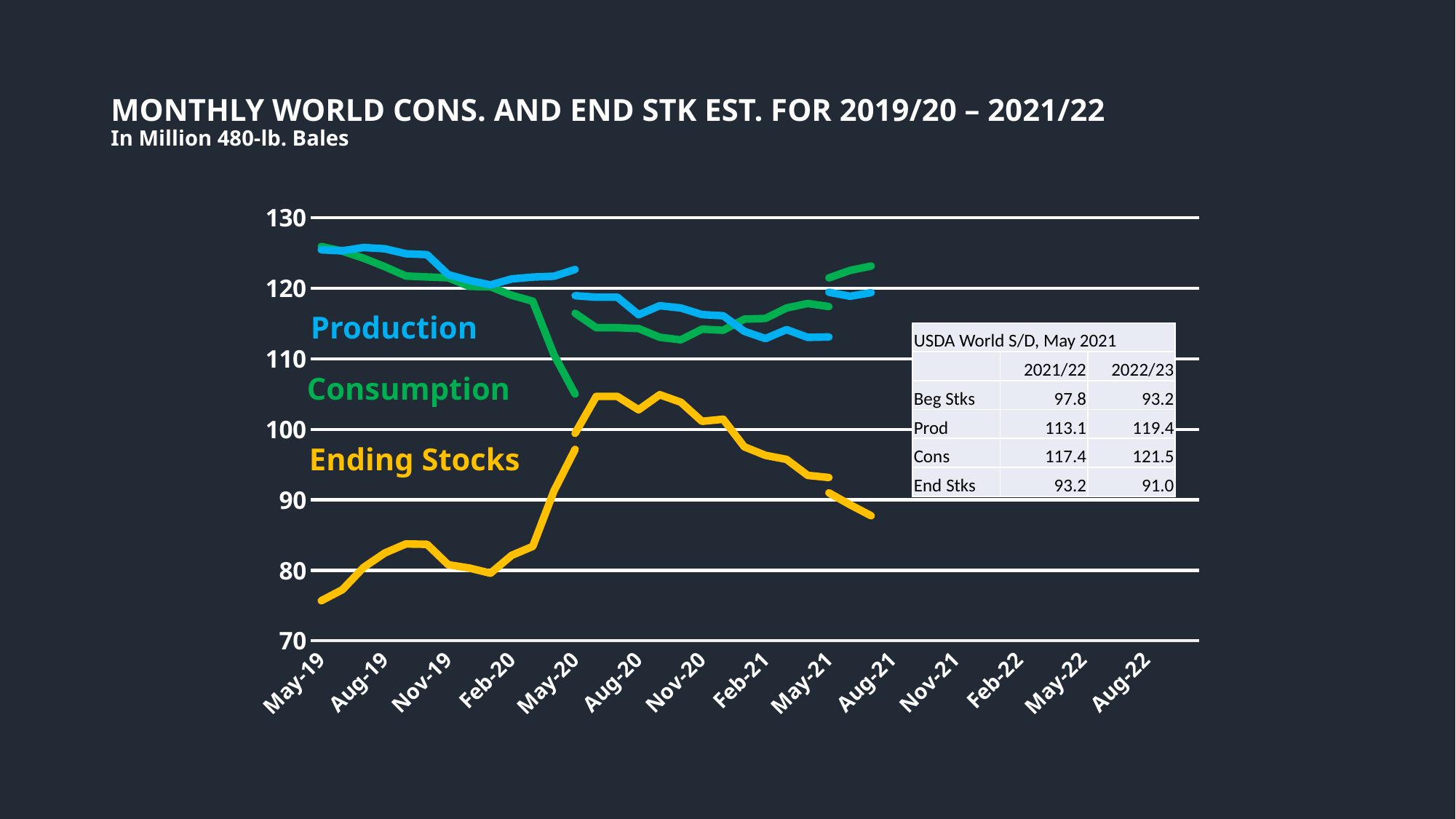
Is the value for Ending Stocks at Aug-20 greater or less than 100? greater Does the Ending Stocks line rise or fall from May-19 to Aug-20? Rise Does the Consumption line rise or fall from May-19 to May-20? Fall What is the title of the chart? MONTHLY WORLD CONS. AND END STK EST. FOR 2019/20 – 2021/22 At Aug-21, which is larger, Production or Consumption? Consumption Is the value for Ending Stocks at May-19 greater or less than 80? less In what units are the chart values expressed? Million 480-lb. Bales Is the value for Ending Stocks at Aug-21 greater or less than 90? less Which series has the lowest values across the whole chart? Ending Stocks How many series are plotted on the chart? 3 What kind of chart is shown on the slide? Line chart